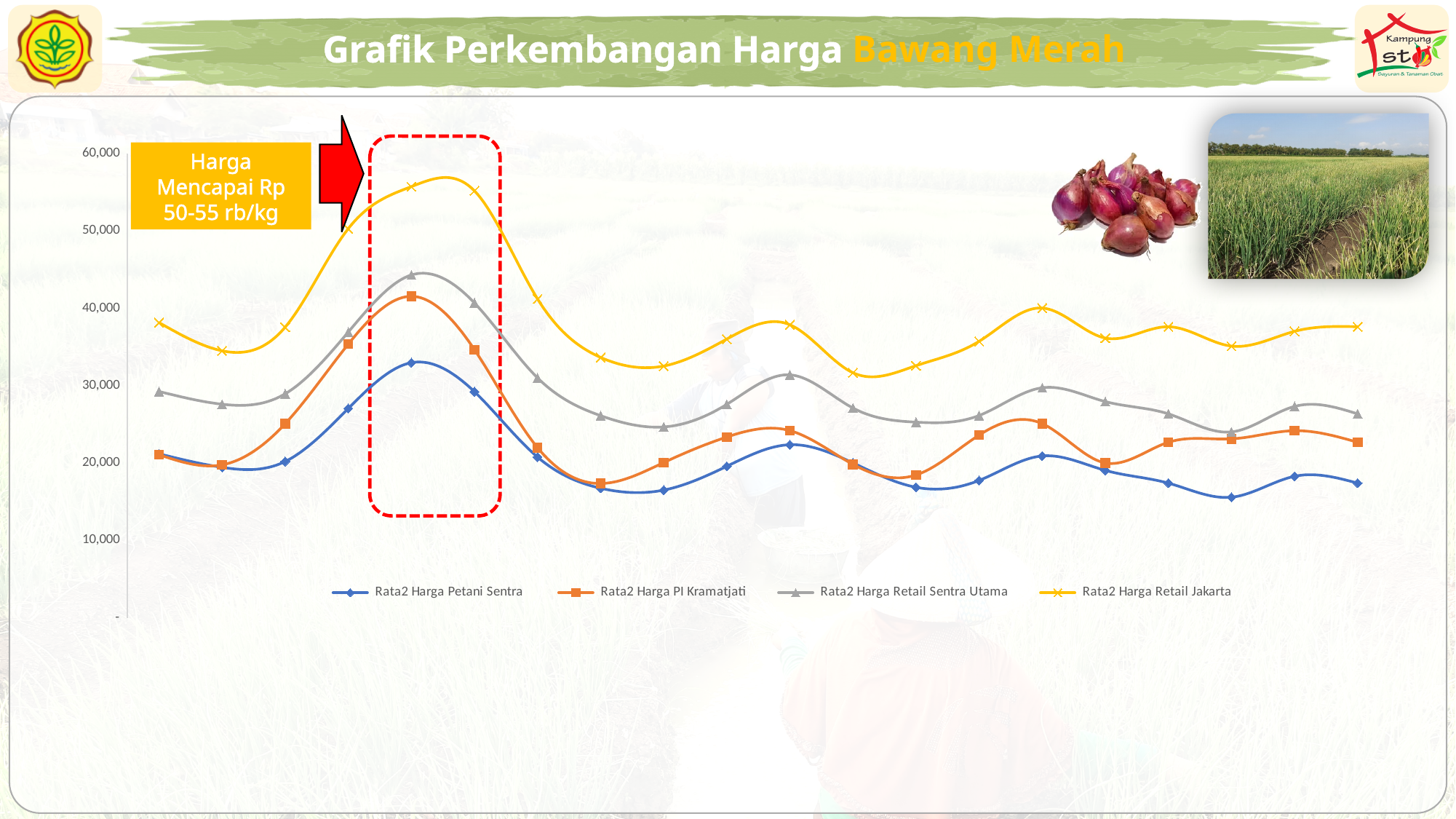
What is the title of the chart? Grafik Perkembangan Harga Bawang Merah At the highlighted peak, which is larger: Rata2 Harga Retail Sentra Utama or Rata2 Harga PI Kramatjati? Rata2 Harga Retail Sentra Utama What kind of chart is shown on the slide? line chart Which series has the highest values across the chart? Rata2 Harga Retail Jakarta Is the peak value of Rata2 Harga Retail Jakarta greater or less than 50,000? greater How many data points does each series have? 20 Is the peak value of Rata2 Harga Petani Sentra greater or less than 30,000? greater Is the peak value of Rata2 Harga PI Kramatjati greater or less than 50,000? less How many series does the legend list? 4 Which series is plotted with the yellow line with x markers? Rata2 Harga Retail Jakarta Which series has the lowest values across the chart? Rata2 Harga Petani Sentra